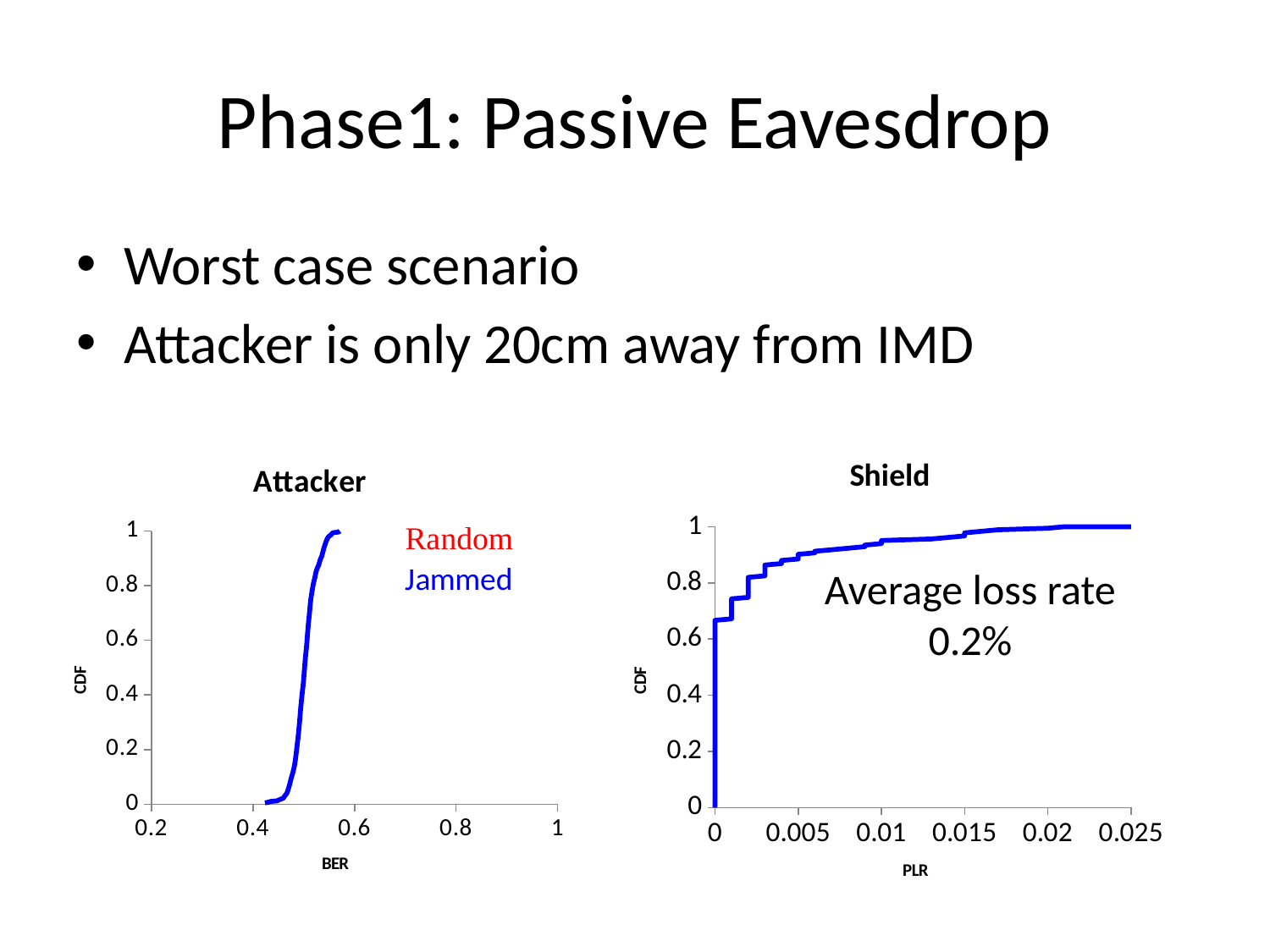
What kind of chart is the Shield chart? line chart What is the maximum value shown on the x axis of the Shield chart? 0.025 In the Shield chart, does the CDF rise or fall as PLR increases? rise What kind of chart is the Attacker chart? line chart In the Attacker chart, what is the label of the x axis? BER In the Shield chart, is the CDF value at a PLR of 0.005 greater or less than 0.6? greater In the Attacker chart, does the CDF rise or fall as BER increases? rise In the Attacker chart, is the CDF value at a BER of 0.4 greater or less than 0.2? less In the Shield chart, what is the label of the x axis? PLR In the Shield chart, is the CDF value at a PLR of 0.01 greater or less than 0.8? greater